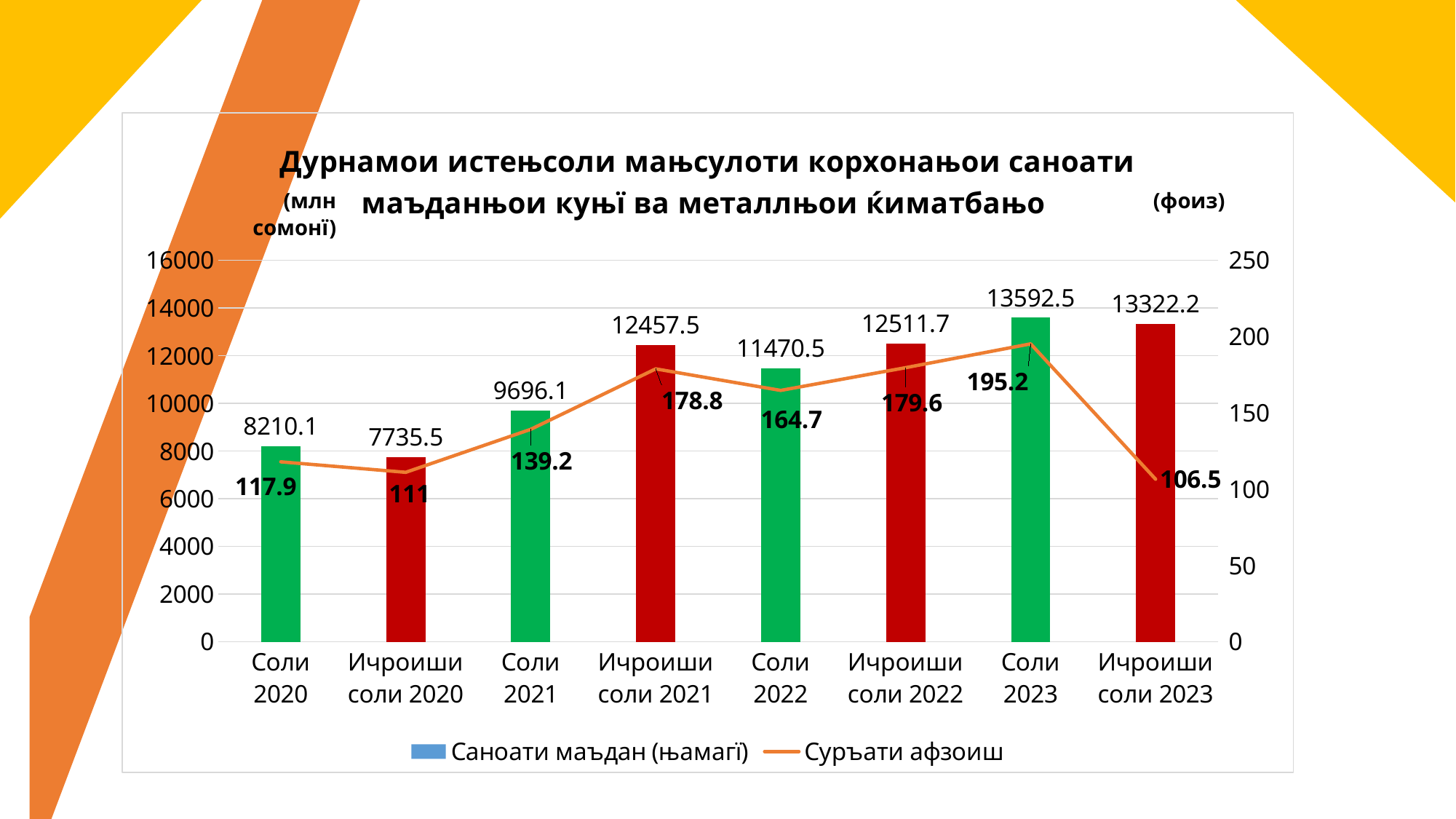
What kinds of chart are combined on this slide? Bar chart and line chart Which has the larger bar value, Соли 2022 or Иҷроиши соли 2022? Иҷроиши соли 2022 What is the bar value for Иҷроиши соли 2023? 13322.2 What is the Суръати афзоиш value for Иҷроиши соли 2022? 179.6 Which category has the highest bar value? Соли 2023 How many series does the legend list? 2 How many categories are shown on the x axis? 8 What is the unit label shown above the right-hand axis? (фоиз) Which category has the lowest Суръати афзоиш value? Иҷроиши соли 2023 Does the Суръати афзоиш line rise or fall between Соли 2023 and Иҷроиши соли 2023? Fall What is the difference between the bar values for Соли 2023 and Иҷроиши соли 2023? 270.3 What is the bar value for Соли 2021? 9696.1